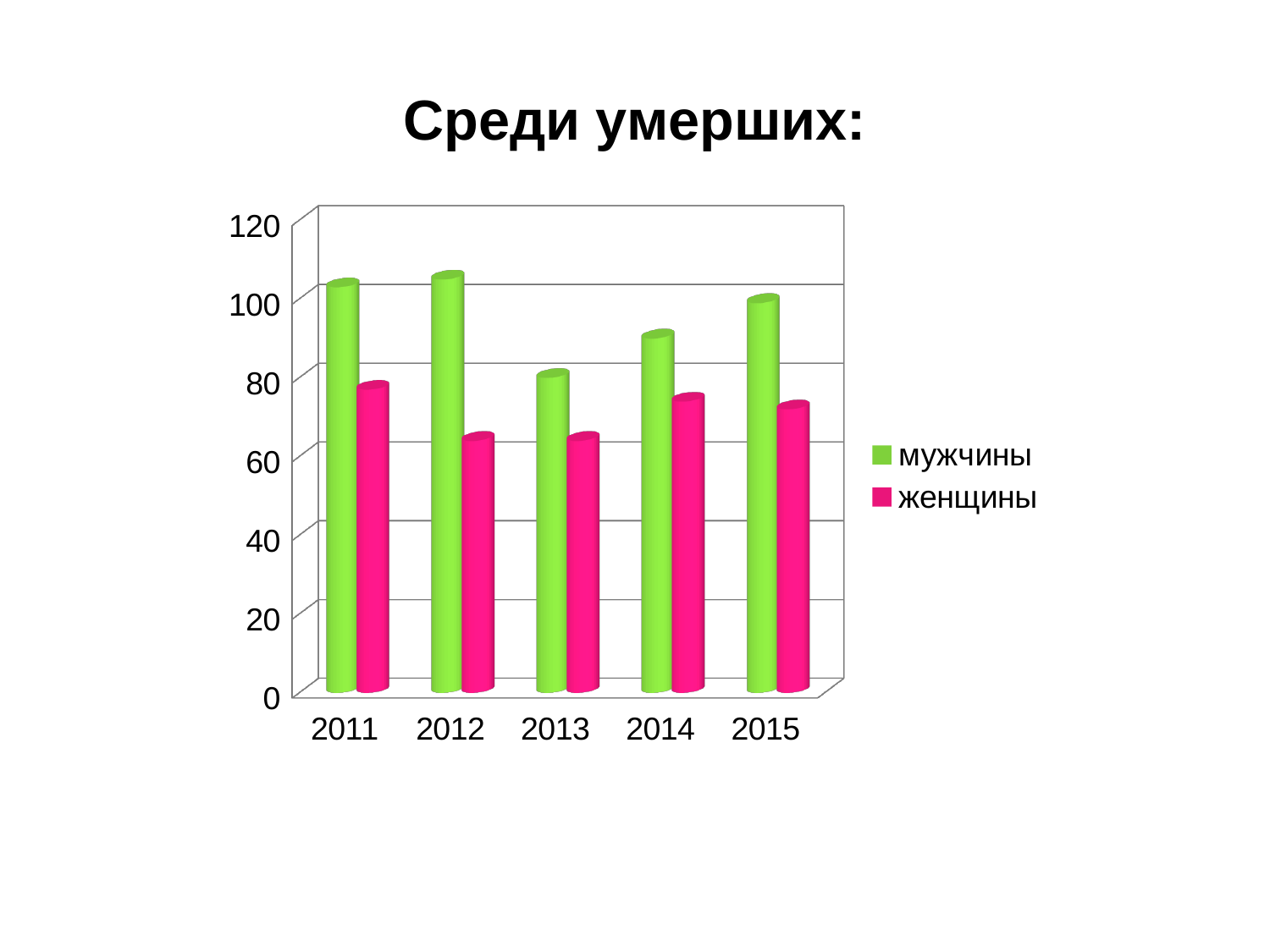
In which year is the value for мужчины the lowest? 2013 Which colour represents the series женщины in the chart? pink Does the value for мужчины rise or fall from 2012 to 2013? fall Is the value for мужчины in 2014 greater or less than 80? greater How many years are shown on the x axis of the chart? 5 What kind of chart is shown on the slide? bar chart In 2015, which is larger: the value for мужчины or the value for женщины? мужчины Is the value for мужчины in 2013 greater or less than 100? less Is the value for женщины in 2012 greater or less than 80? less What is the title of the chart? Среди умерших: How many series does the legend list? 2 In 2013, which is larger: the value for мужчины or the value for женщины? мужчины